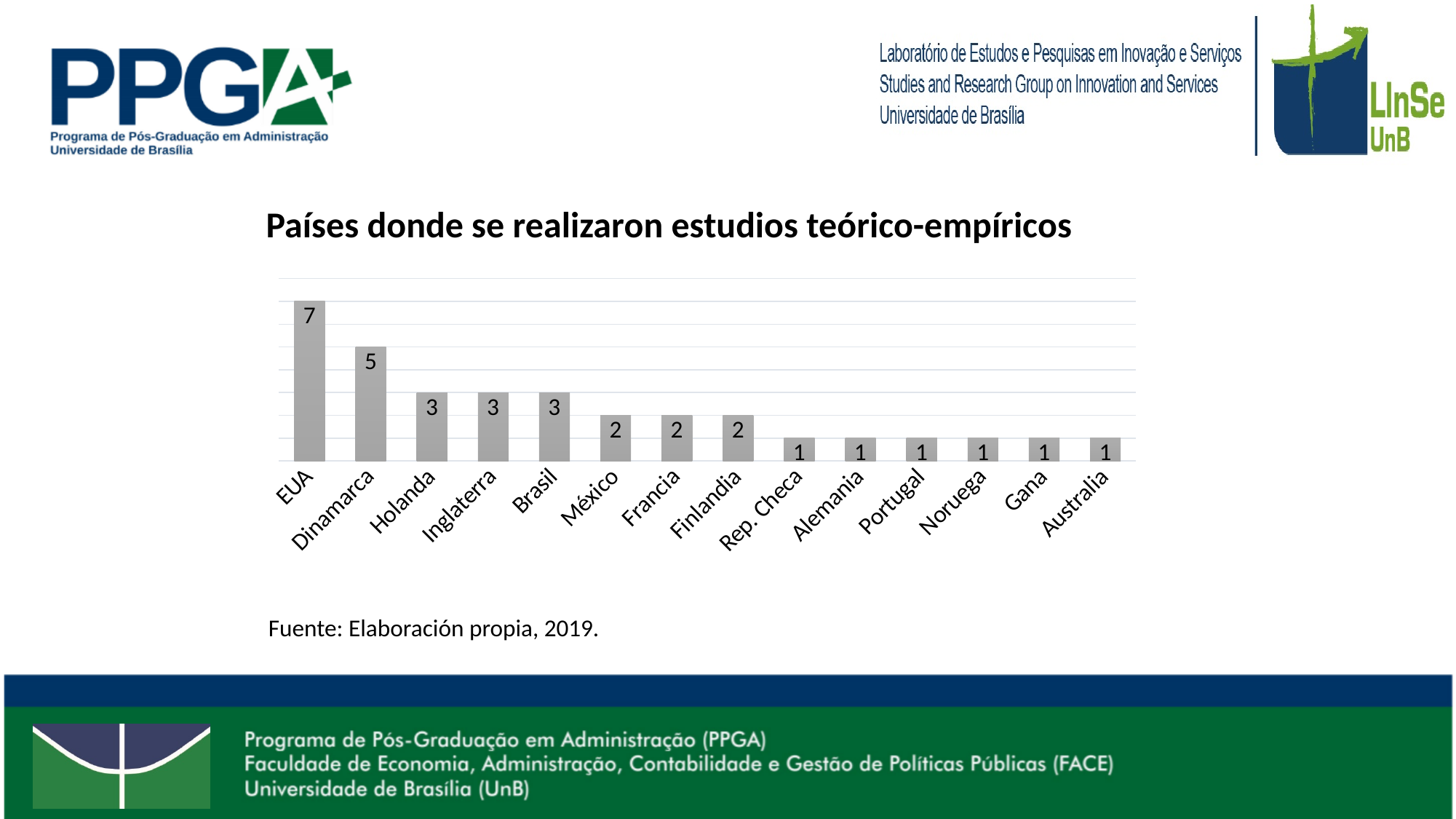
Do the values rise or fall from left to right along the x axis? Fall What is the title of the chart? Países donde se realizaron estudios teórico-empíricos How many countries are shown on the chart? 14 What is the difference between the values for EUA and Dinamarca? 2 What is the value for Dinamarca? 5 What is the difference between the values for Holanda and Finlandia? 1 What is the value for Portugal? 1 Which is larger, the value for Brasil or the value for Francia? Brasil What is the value for EUA? 7 What is the value for México? 2 Which country has the highest value? EUA What kind of chart is shown? Bar chart